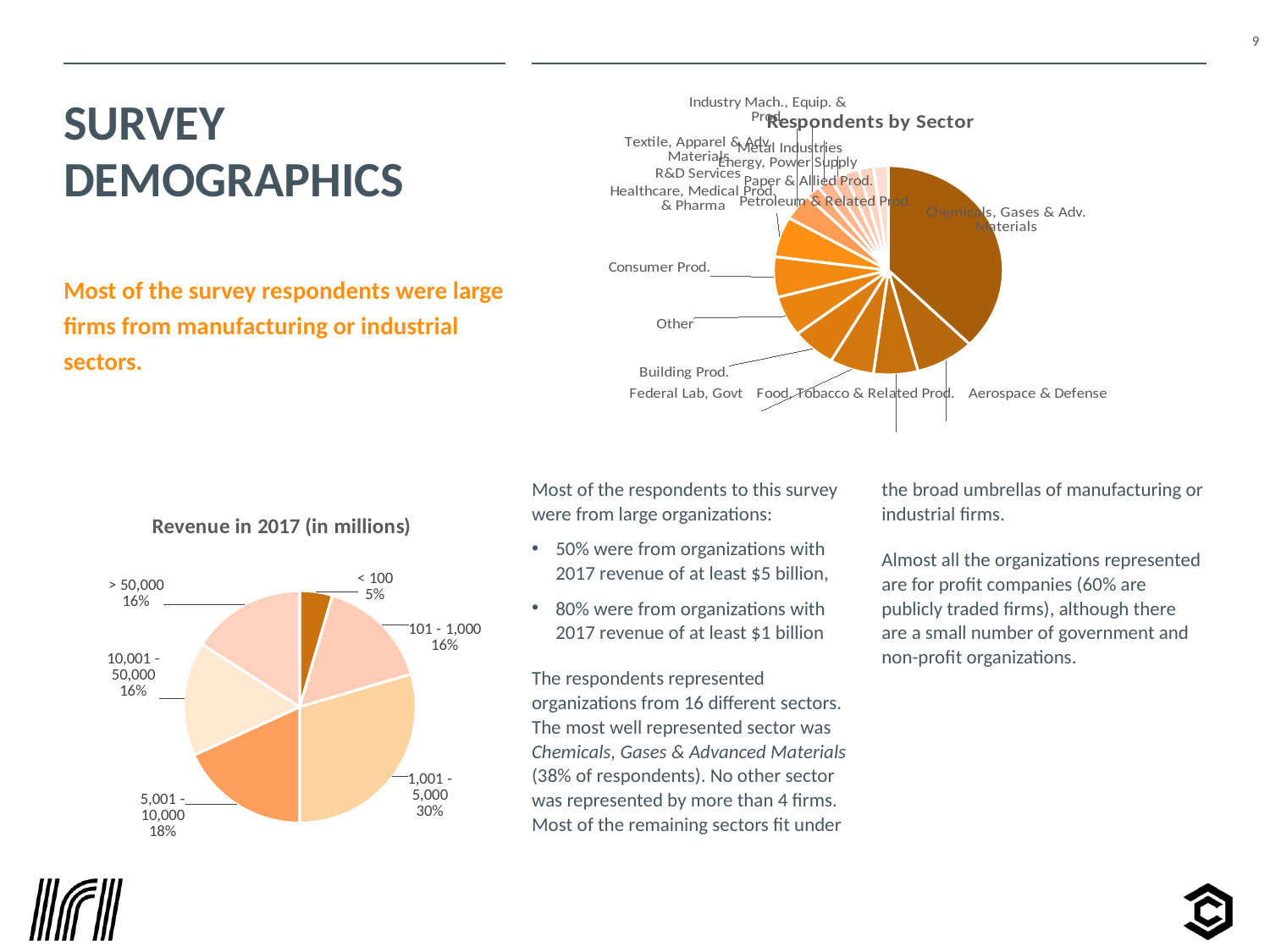
In the "Revenue in 2017 (in millions)" chart, how many percentage points larger is the 1,001 - 5,000 share than the 5,001 - 10,000 share? 12 percentage points In the "Revenue in 2017 (in millions)" chart, what is the combined share of the < 100 and 101 - 1,000 categories? 21% In the "Revenue in 2017 (in millions)" chart, which category has the largest share? 1,001 - 5,000 In the "Revenue in 2017 (in millions)" chart, what share of respondents is in the < 100 category? 5% In the "Respondents by Sector" chart, which sector has the largest slice? Chemicals, Gases & Adv. Materials What kind of chart is the "Respondents by Sector" chart? Pie chart In the "Revenue in 2017 (in millions)" chart, which is larger: the 5,001 - 10,000 share or the > 50,000 share? 5,001 - 10,000 In the "Revenue in 2017 (in millions)" chart, which category has the smallest share? < 100 What kind of chart is the "Revenue in 2017 (in millions)" chart? Pie chart How many categories are shown in the "Revenue in 2017 (in millions)" chart? 6 In the "Revenue in 2017 (in millions)" chart, what share of respondents is in the 1,001 - 5,000 category? 30% In the "Revenue in 2017 (in millions)" chart, what share of respondents is in the > 50,000 category? 16%